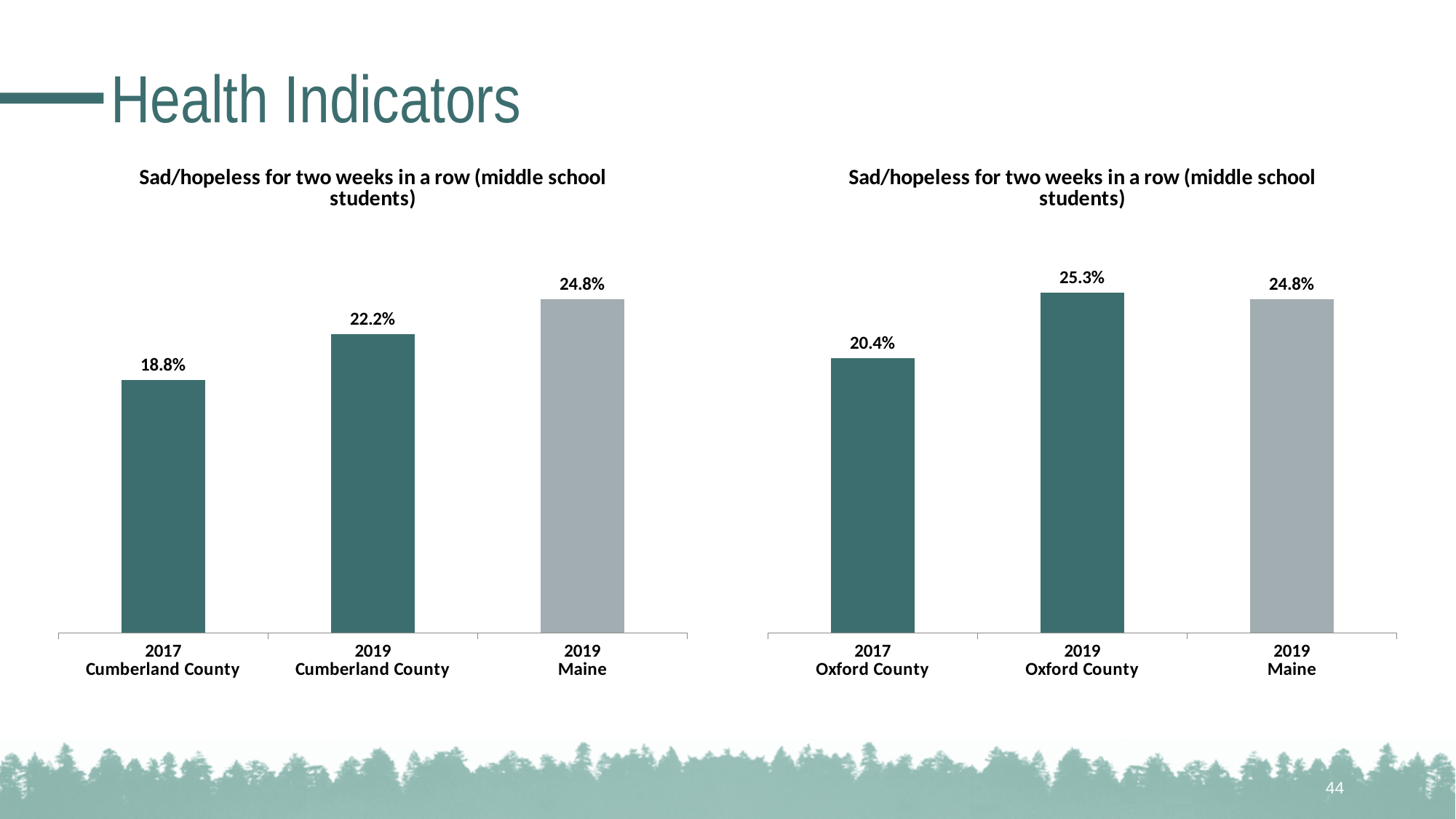
In the right chart (Oxford County), which is larger: the 2019 Oxford County value or the 2019 Maine value? 2019 Oxford County In the right chart (Oxford County), which category has the lowest value? 2017 Oxford County What kind of chart is the right chart (Oxford County)? Bar chart In the left chart (Cumberland County), what is the value for 2017 Cumberland County? 18.8% How many bars are in the left chart (Cumberland County)? 3 In the left chart (Cumberland County), which category has the highest value? 2019 Maine What is the title of the left chart? Sad/hopeless for two weeks in a row (middle school students) In the left chart (Cumberland County), what is the difference between the 2019 Maine value and the 2019 Cumberland County value? 2.6% In the left chart (Cumberland County), what is the value for 2019 Cumberland County? 22.2% In the right chart (Oxford County), what is the difference between the 2019 Oxford County value and the 2017 Oxford County value? 4.9% In the right chart (Oxford County), what is the value for 2017 Oxford County? 20.4% In the right chart (Oxford County), what is the value for 2019 Oxford County? 25.3%